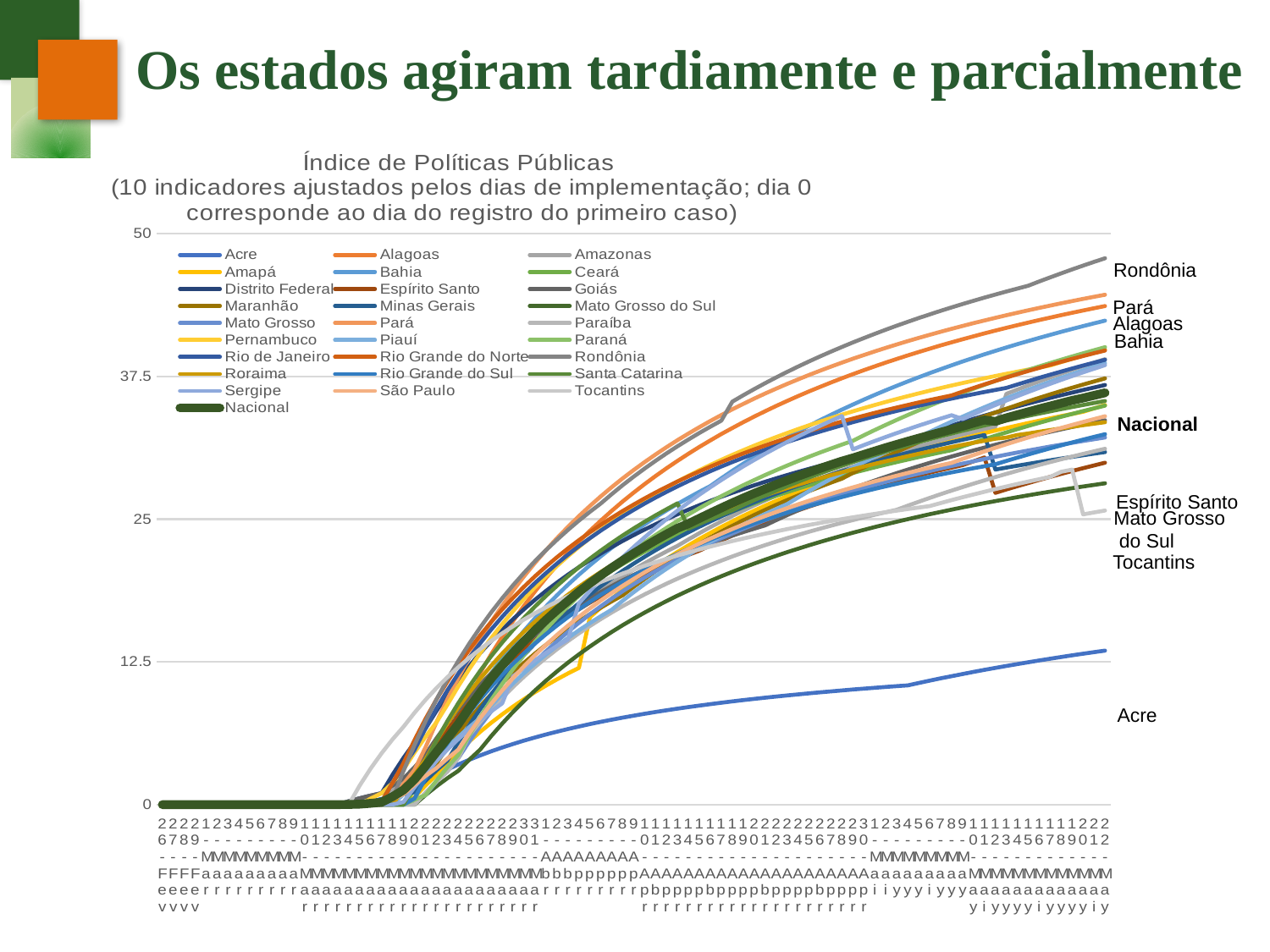
At the right end of the chart, is the value for Nacional greater or less than 25? greater At the right end of the chart, is the value for Acre greater or less than 25? less What is the first line of the chart title? Índice de Políticas Públicas At the right end of the chart, which is larger, the value for Rondônia or the value for Acre? Rondônia Do the values of the lines generally rise or fall along the x axis? rise At the right end of the chart, is the value for Nacional greater or less than 37.5? less How many series does the chart legend list? 28 What kind of chart is shown on the slide? line chart Which series has the lowest value at the right end of the chart? Acre Which series has the highest value at the right end of the chart? Rondônia What is the highest value shown on the y axis of the chart? 50